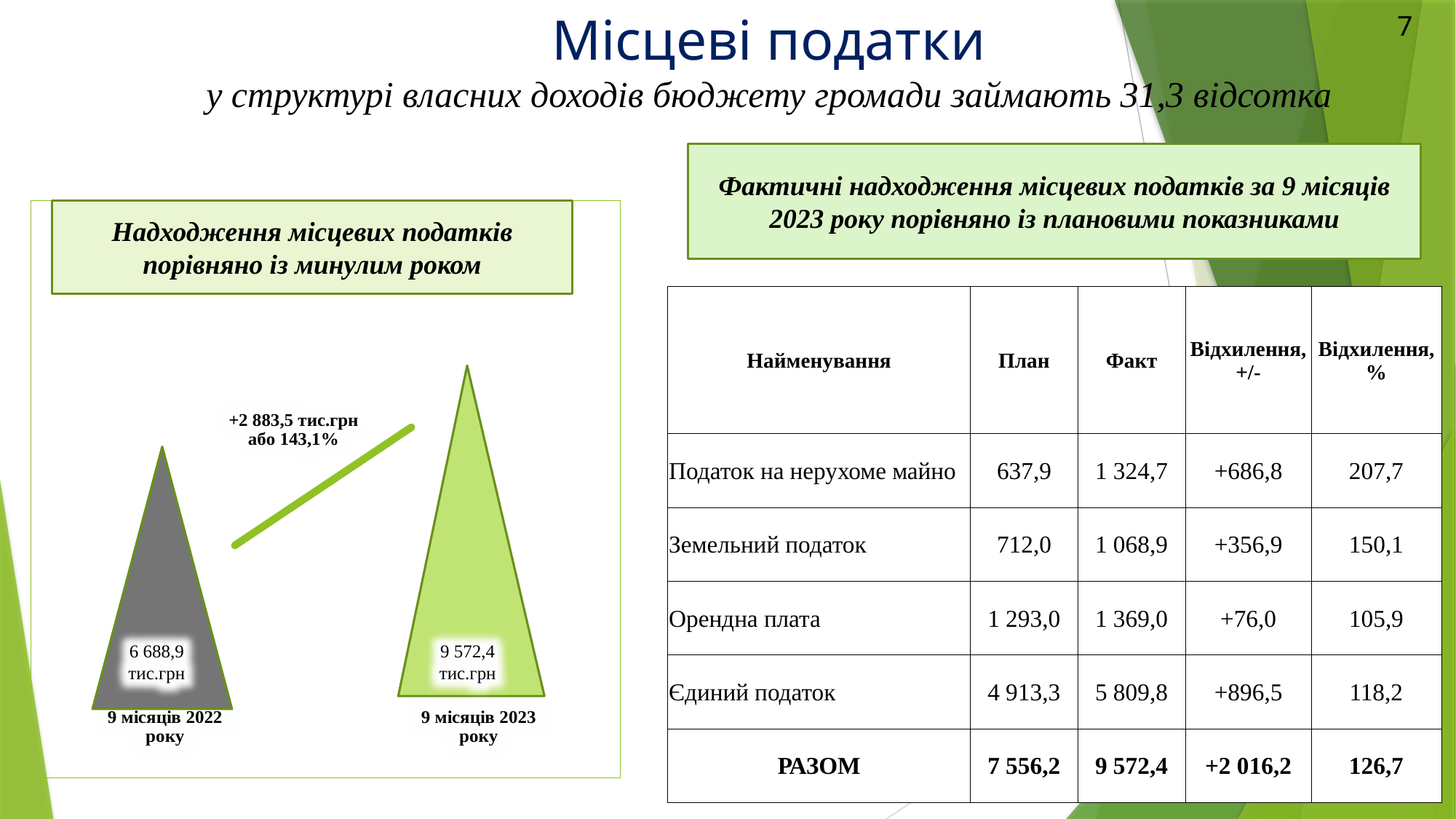
In the chart 'Надходження місцевих податків порівняно із минулим роком', what is the value for 9 місяців 2022 року? 6 688,9 тис.грн In the chart 'Надходження місцевих податків порівняно із минулим роком', do the values rise or fall from 2022 to 2023? rise What is the title of the chart on the left side of the slide? Надходження місцевих податків порівняно із минулим роком In the chart 'Надходження місцевих податків порівняно із минулим роком', is the value for 9 місяців 2023 року larger or smaller than the value for 9 місяців 2022 року? larger In the chart 'Надходження місцевих податків порівняно із минулим роком', what is the value for 9 місяців 2023 року? 9 572,4 тис.грн How many periods are compared in the chart 'Надходження місцевих податків порівняно із минулим роком'? 2 In the chart 'Надходження місцевих податків порівняно із минулим роком', which period has the lower value? 9 місяців 2022 року In the chart 'Надходження місцевих податків порівняно із минулим роком', what colour is the triangle for 9 місяців 2022 року? grey In the chart 'Надходження місцевих податків порівняно із минулим роком', which period has the higher value? 9 місяців 2023 року In the chart 'Надходження місцевих податків порівняно із минулим роком', what is the difference between the 2023 and 2022 values as printed on the slide? +2 883,5 тис.грн In the chart 'Надходження місцевих податків порівняно із минулим роком', what percentage is the 2023 value relative to the 2022 value, as printed on the slide? 143,1%